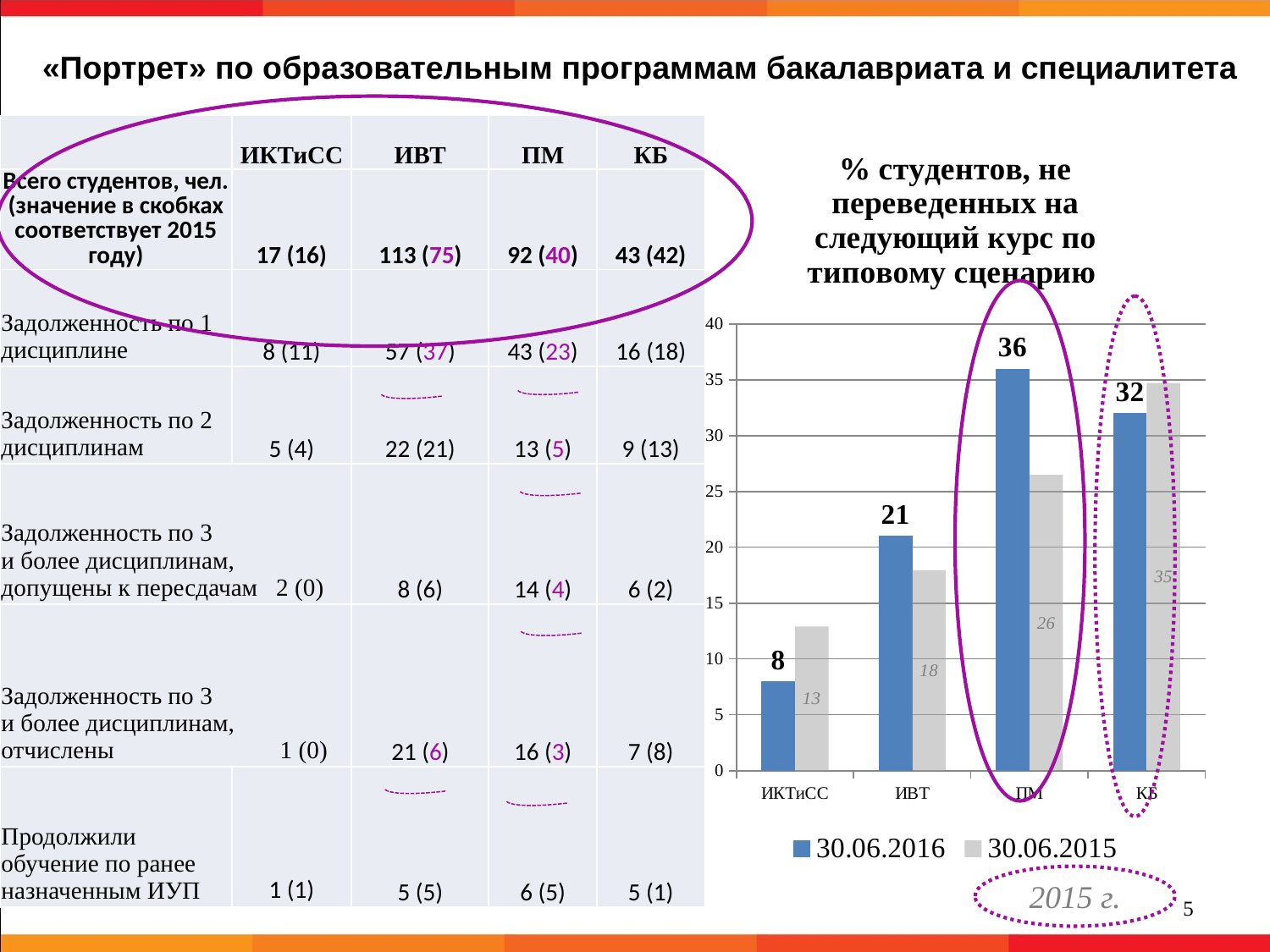
What is the difference between the 30.06.2016 and 30.06.2015 values for ПМ? 10 What are the two series named in the chart legend? 30.06.2016 and 30.06.2015 Is the 30.06.2016 value for ИВТ greater or less than 20? greater What kind of chart is shown on the slide? bar chart How many series does the chart legend list? 2 Which category has the lowest value in the 30.06.2016 series? ИКТиСС What is the value for ИКТиСС in the 30.06.2015 series? 13 Which category has the highest value in the 30.06.2016 series? ПМ What is the value for ПМ in the 30.06.2016 series? 36 How many categories are shown on the x axis of the chart? 4 Which is larger for КБ: the 30.06.2016 value or the 30.06.2015 value? 30.06.2015 What is the value for КБ in the 30.06.2015 series? 35